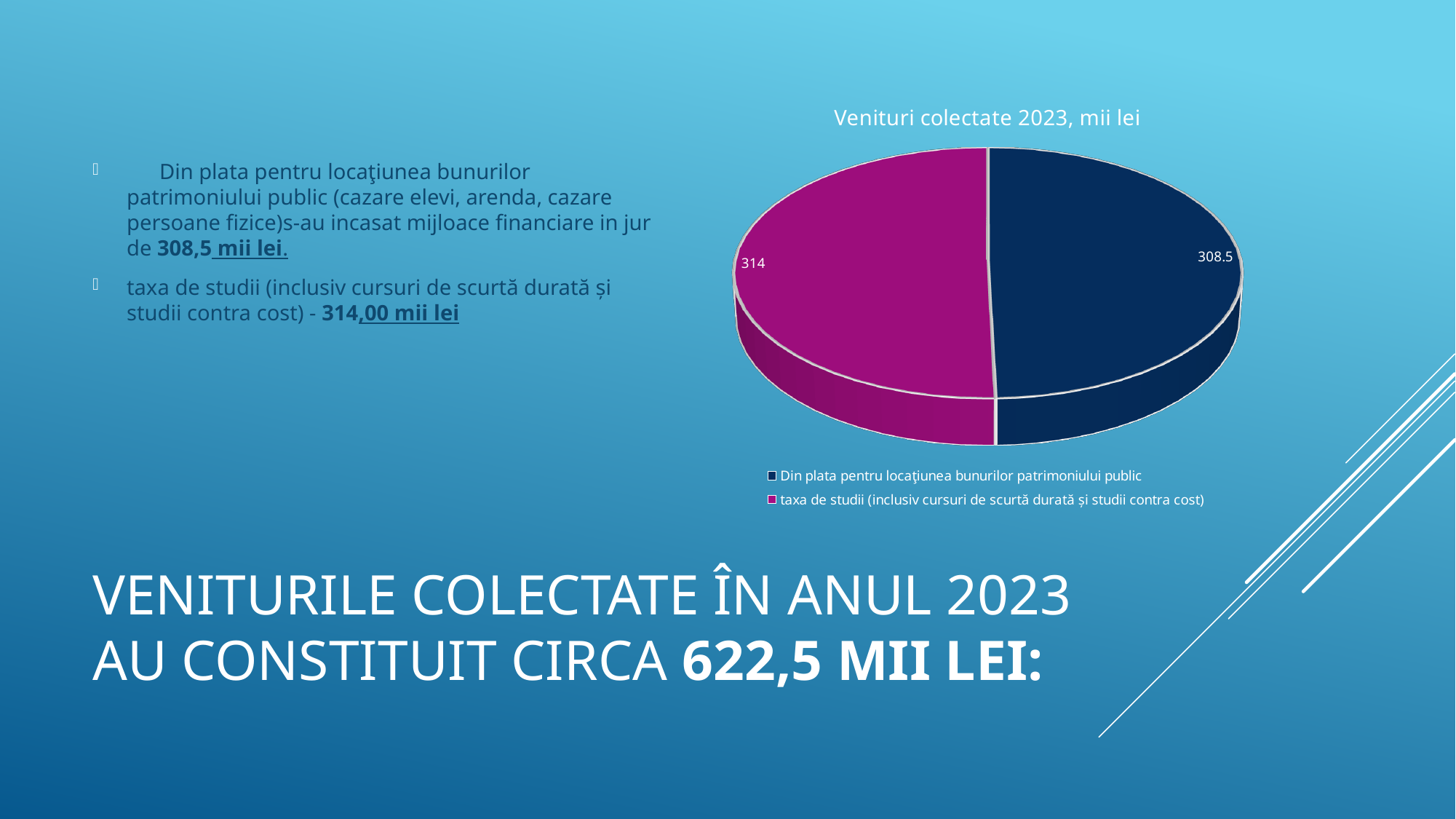
How many slices does the pie chart have? 2 Which slice has the larger value according to the data labels? taxa de studii (inclusiv cursuri de scurtă durată și studii contra cost) What is the total of the two slices in the pie chart? 622.5 What is the value of the slice for 'Din plata pentru locaţiunea bunurilor patrimoniului public'? 308.5 How many entries does the chart legend list? 2 What is the difference between the 'taxa de studii' slice and the 'Din plata pentru locaţiunea bunurilor patrimoniului public' slice? 5.5 What is the title of the chart? Venituri colectate 2023, mii lei What colour is the slice for 'taxa de studii (inclusiv cursuri de scurtă durată și studii contra cost)'? magenta Which slice has the smaller value according to the data labels? Din plata pentru locaţiunea bunurilor patrimoniului public What type of chart is shown on the slide? pie chart What is the value of the slice for 'taxa de studii (inclusiv cursuri de scurtă durată și studii contra cost)'? 314 Is the value for 'taxa de studii' larger or smaller than the value for 'Din plata pentru locaţiunea bunurilor patrimoniului public'? larger